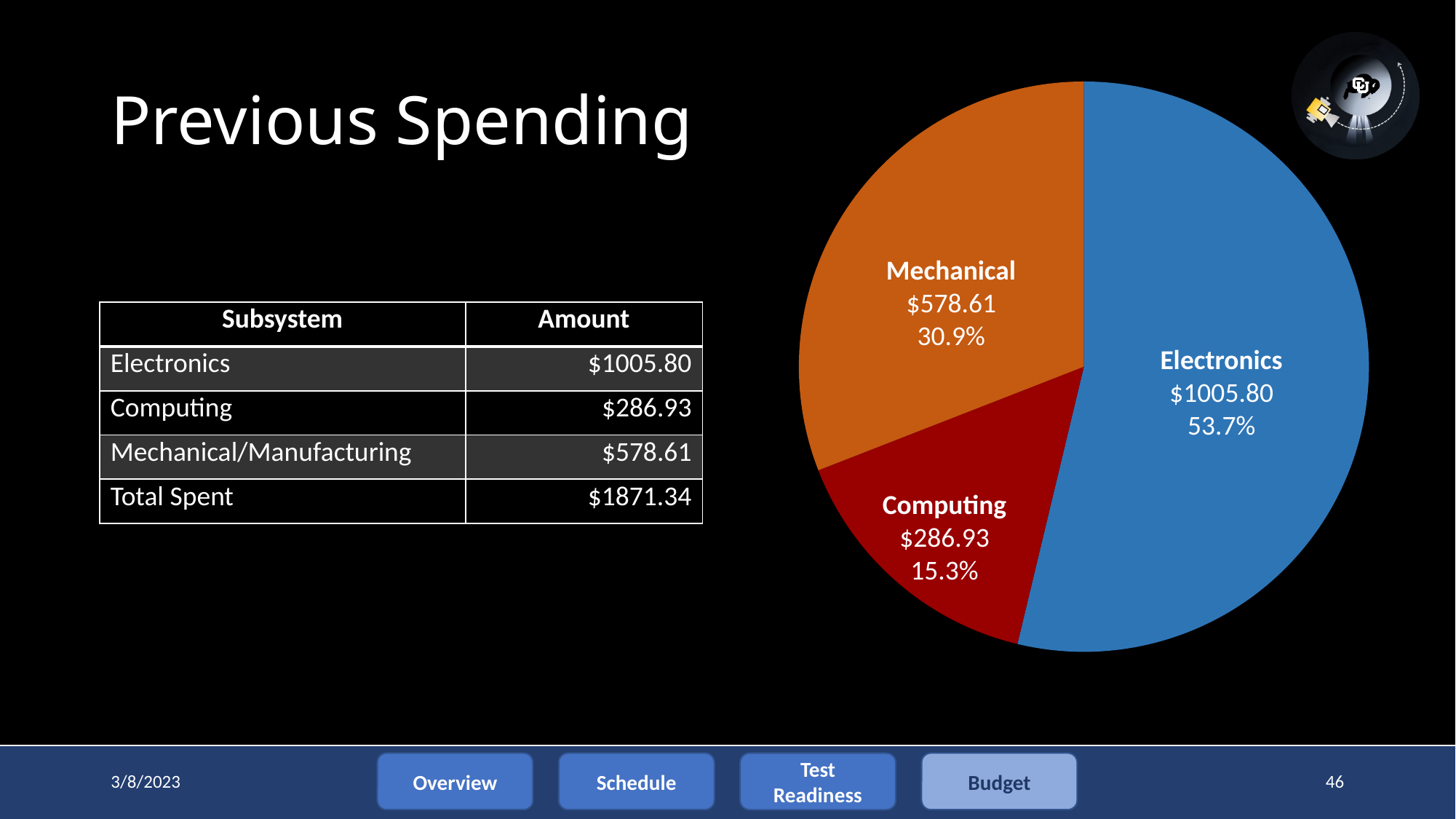
What share of the pie does the Electronics slice represent? 53.7% What is the difference in amount between the Electronics slice and the Mechanical slice? $427.19 Which slice of the pie chart is the smallest? Computing What kind of chart is shown on the slide? pie chart What share of the pie does the Computing slice represent? 15.3% Which slice of the pie chart is the largest? Electronics What colour is the Computing slice in the pie chart? red What is the amount shown for the Electronics slice? $1005.80 Which is larger, the Mechanical slice or the Computing slice? Mechanical How many slices does the pie chart have? 3 What is the amount shown for the Mechanical slice? $578.61 What is the amount shown for the Computing slice? $286.93